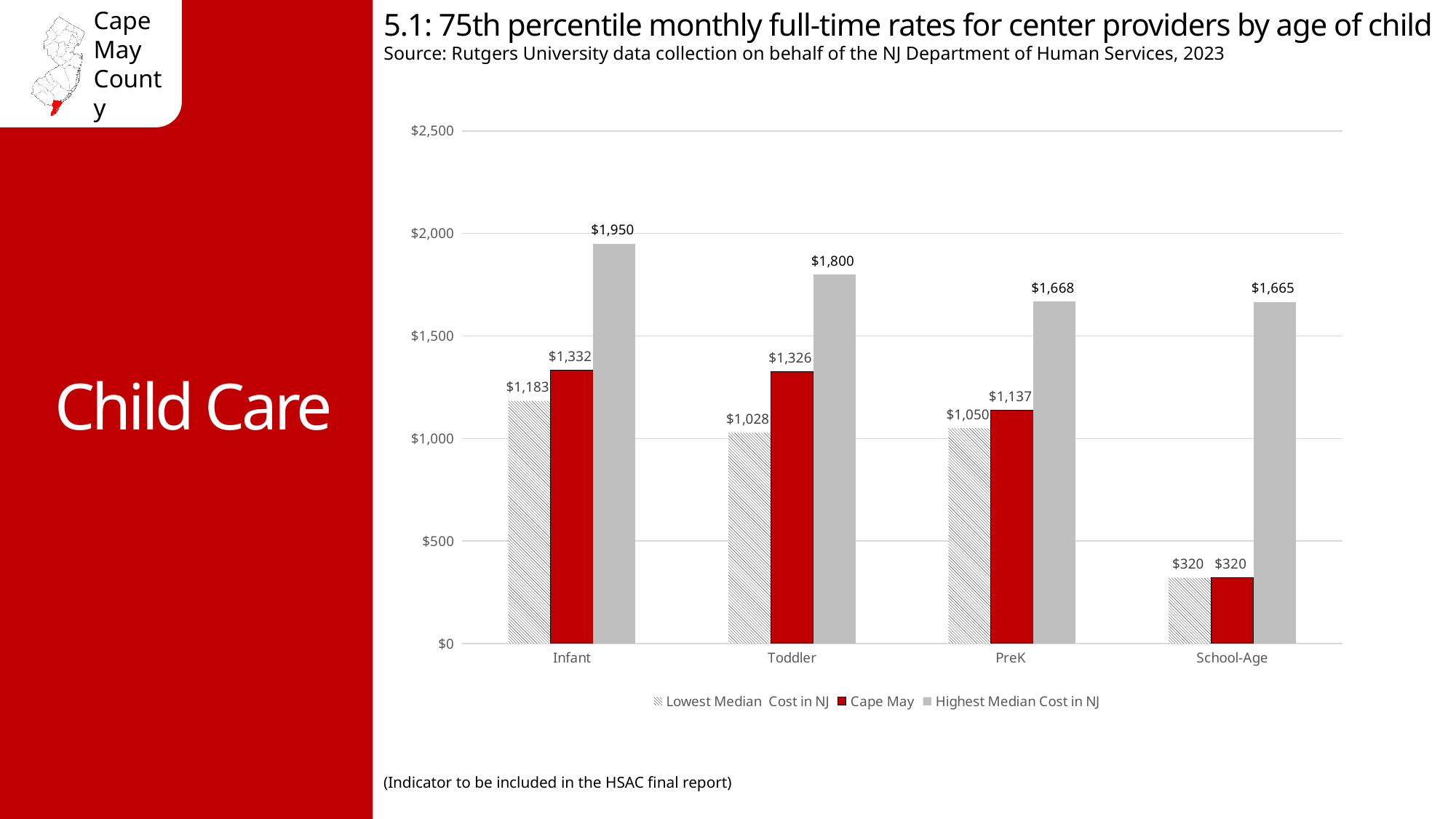
How many series does the legend list? 3 Does the Cape May value rise or fall from Infant to School-Age? Fall What kind of chart is shown? Bar chart Which age group has the highest Highest Median Cost in NJ? Infant Which age group has the lowest Cape May value? School-Age What is the Highest Median Cost in NJ for Toddler? $1,800 What is the Cape May value for School-Age? $320 How many age groups are shown on the x axis? 4 What is the difference between the Highest Median Cost in NJ and the Cape May value for Infant? $618 What is the Lowest Median Cost in NJ for PreK? $1,050 Which is larger for Toddler: the Cape May value or the Lowest Median Cost in NJ? Cape May What is the Cape May value for Infant? $1,332